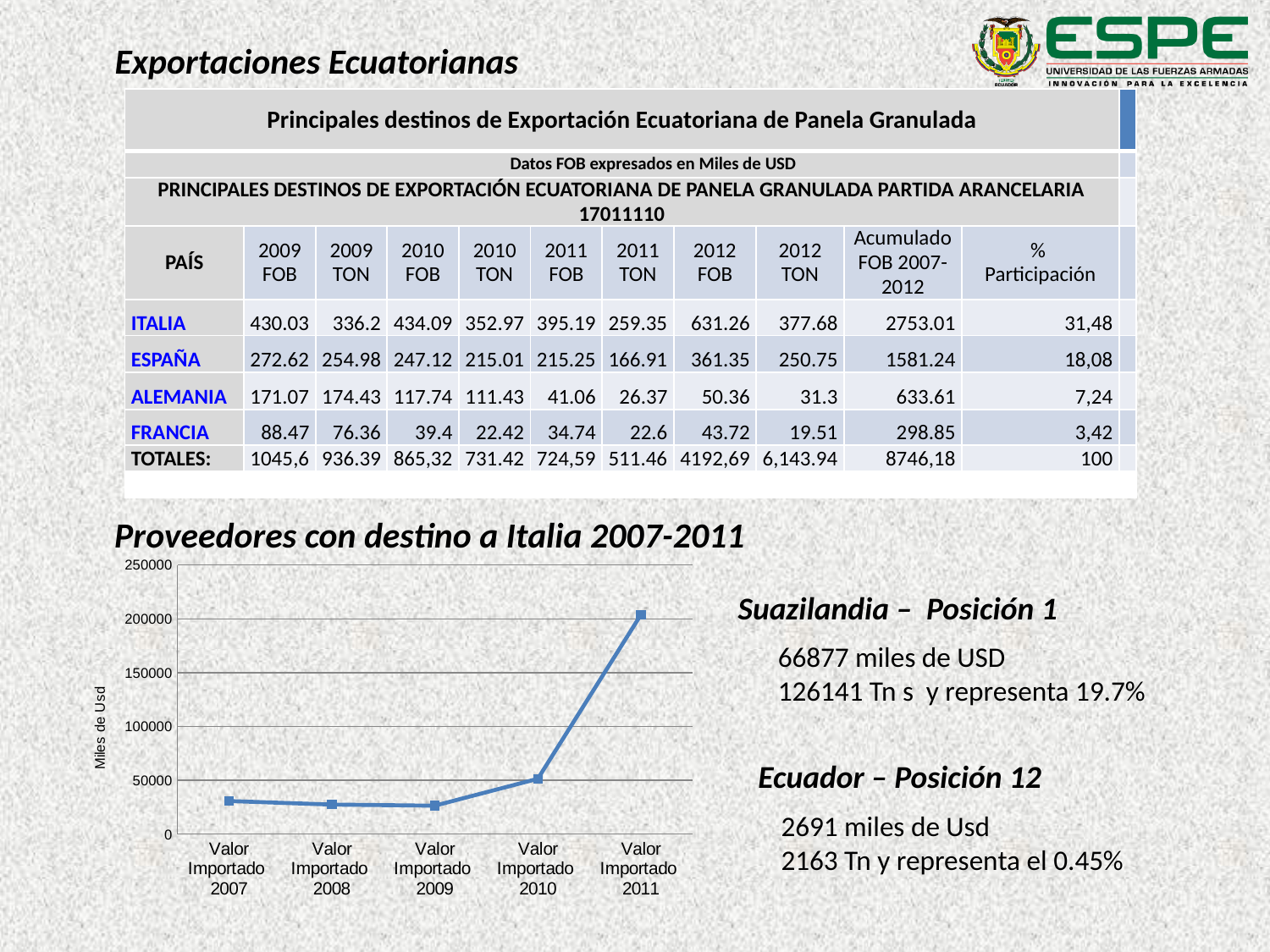
On the 'Proveedores con destino a Italia 2007-2011' chart, is the value for Valor Importado 2010 greater or less than 100000? less On the 'Proveedores con destino a Italia 2007-2011' chart, is the value for Valor Importado 2009 greater or less than 50000? less On the 'Proveedores con destino a Italia 2007-2011' chart, which is larger: the value for Valor Importado 2010 or Valor Importado 2009? Valor Importado 2010 On the 'Proveedores con destino a Italia 2007-2011' chart, is the value for Valor Importado 2011 greater or less than 150000? greater What kind of chart is shown under the heading 'Proveedores con destino a Italia 2007-2011'? line chart On the 'Proveedores con destino a Italia 2007-2011' chart, which category has the highest value? Valor Importado 2011 On the 'Proveedores con destino a Italia 2007-2011' chart, do the values rise or fall from Valor Importado 2009 to Valor Importado 2011? rise What is the label on the vertical axis of the 'Proveedores con destino a Italia 2007-2011' chart? Miles de Usd What is the highest tick value shown on the vertical axis of the 'Proveedores con destino a Italia 2007-2011' chart? 250000 On the 'Proveedores con destino a Italia 2007-2011' chart, which is larger: the value for Valor Importado 2011 or Valor Importado 2007? Valor Importado 2011 How many data points are plotted on the 'Proveedores con destino a Italia 2007-2011' line chart? 5